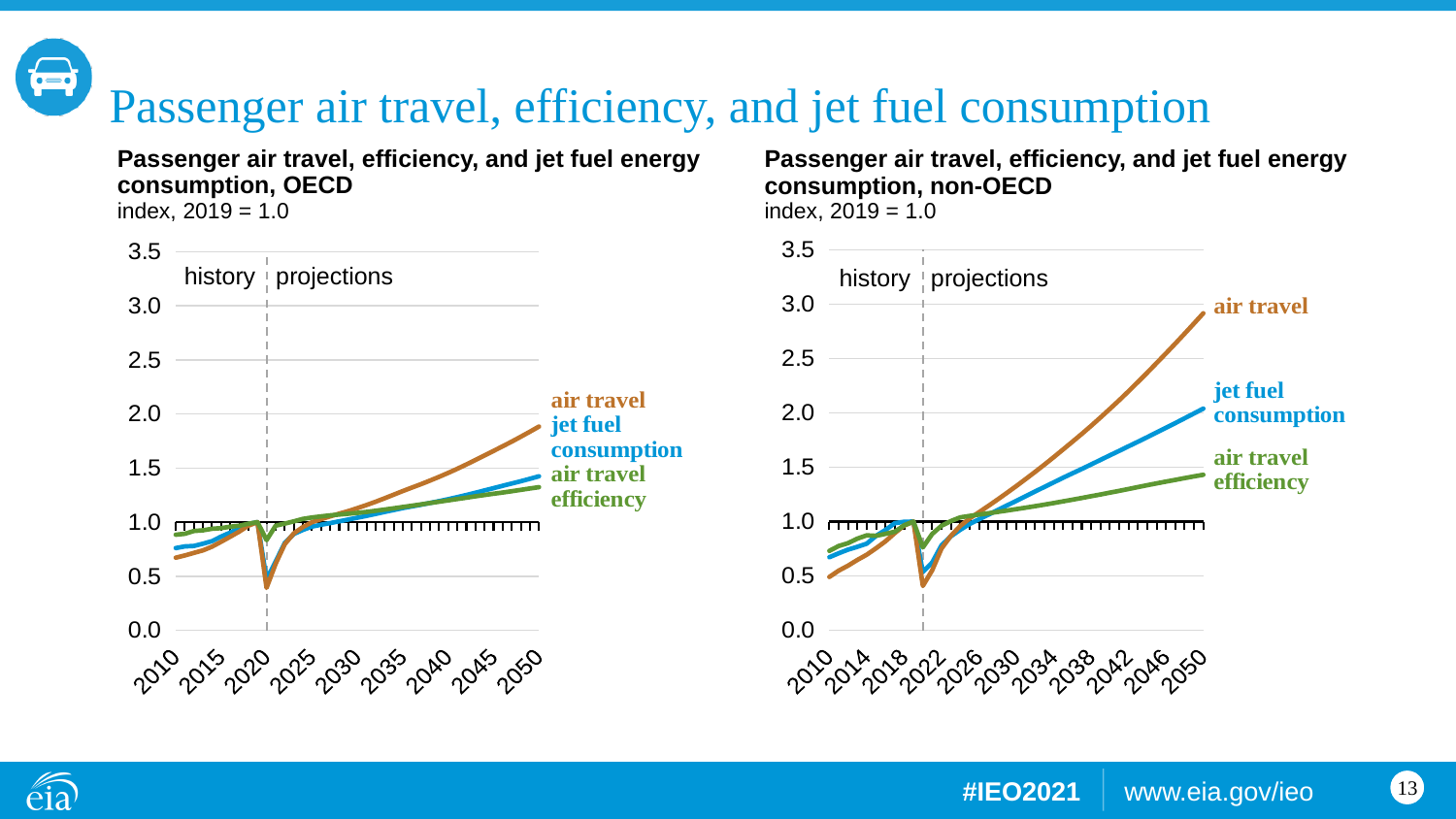
How many series are plotted on the 'Passenger air travel, efficiency, and jet fuel energy consumption, non-OECD' chart? 3 On the OECD chart, is the value for air travel in 2050 greater or less than 2.0? less On the OECD chart, which series has the highest value in 2050? air travel On the OECD chart, is the value for air travel at its 2020 low point greater or less than 0.5? less What is the index value of the series in the base year 2019 on both charts? 1.0 What type of chart is the 'Passenger air travel, efficiency, and jet fuel energy consumption, OECD' chart? line chart On the non-OECD chart, is the value for jet fuel consumption in 2050 greater or less than 1.5? greater Which is larger in 2050: air travel on the OECD chart or air travel on the non-OECD chart? non-OECD On the non-OECD chart, which series has the lowest value in 2050? air travel efficiency On the non-OECD chart, does the air travel series rise or fall over the projection period from 2022 to 2050? rise What two periods does the vertical dashed line separate on each chart? history and projections